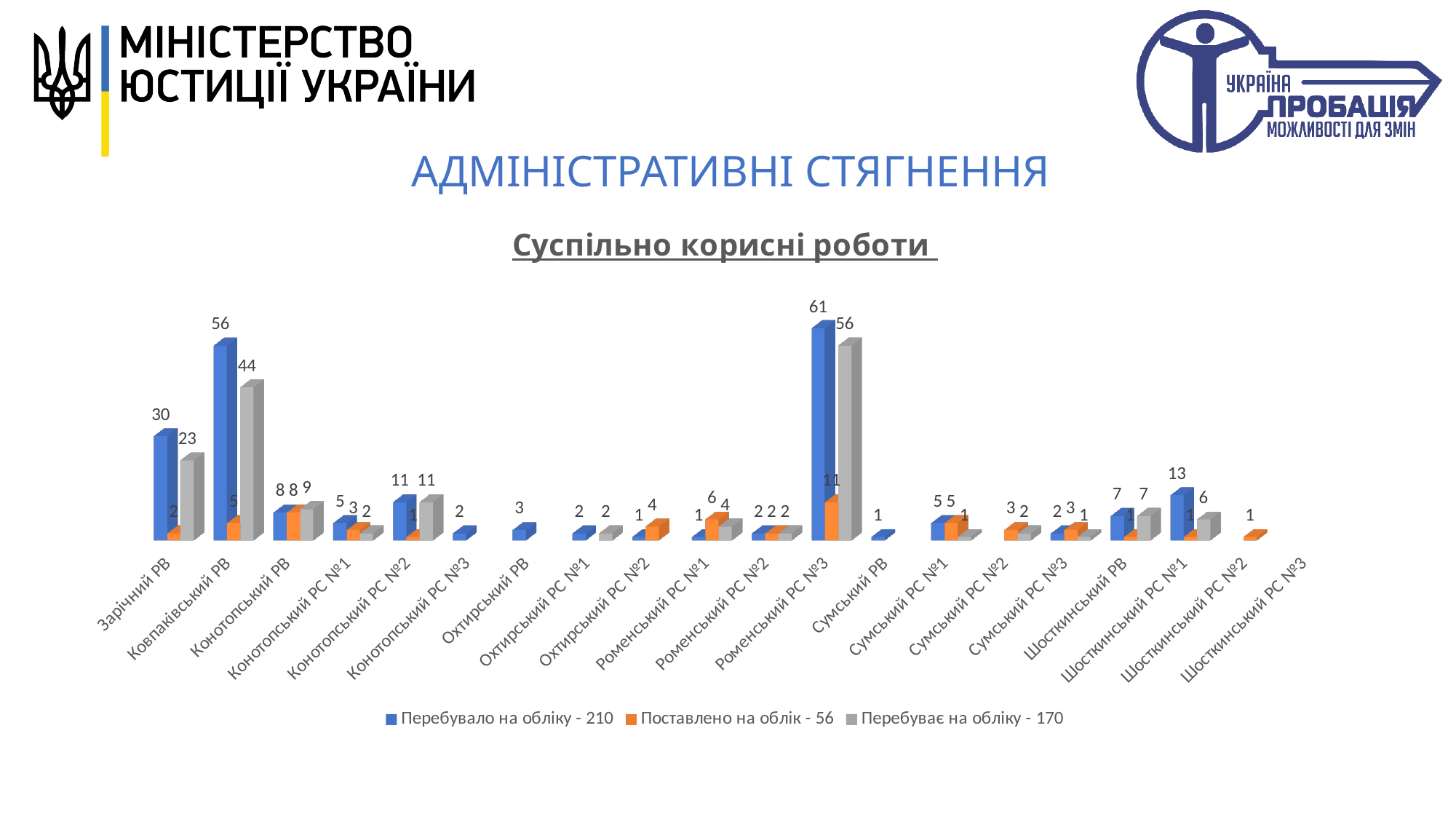
What is the value of 'Перебуває на обліку' for Роменський РС №3? 56 Which category has the highest value for 'Перебувало на обліку'? Роменський РС №3 Which has the larger 'Перебувало на обліку' value: Зарічний РВ or Ковпаківський РВ? Ковпаківський РВ What total is shown in the legend for the series 'Поставлено на облік'? 56 What is the value of 'Перебувало на обліку' for Ковпаківський РВ? 56 How many categories are shown along the x axis? 20 For Роменський РС №3, what is the difference between 'Перебувало на обліку' and 'Перебуває на обліку'? 5 What is the value of 'Перебувало на обліку' for Шосткинський РС №1? 13 Which category has the highest value for 'Поставлено на облік'? Роменський РС №3 What is the value of 'Поставлено на облік' for Роменський РС №1? 6 What kind of chart is shown on the slide? bar chart How many series does the legend list? 3